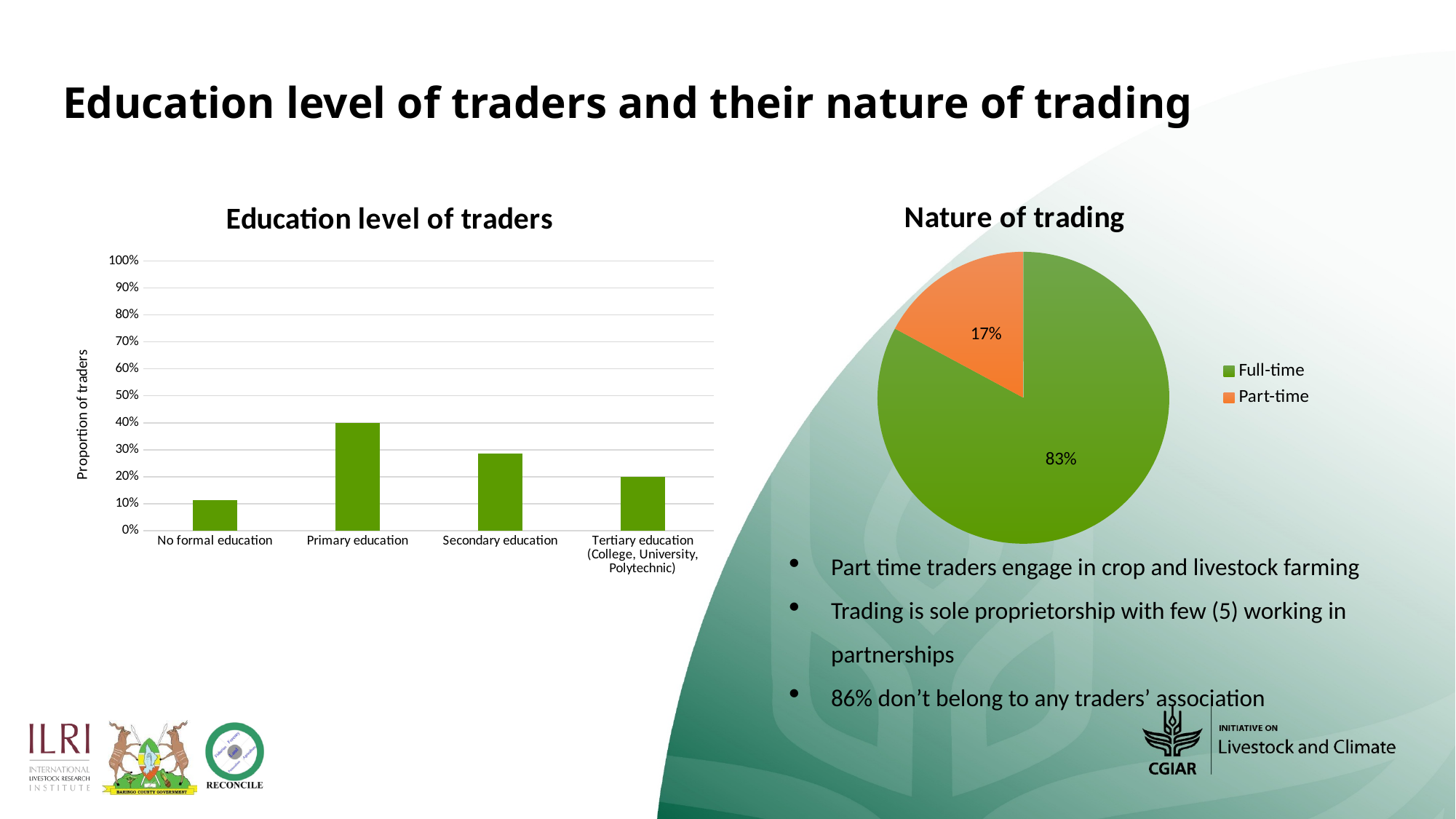
In the 'Education level of traders' chart, which education level has the highest proportion of traders? Primary education In the 'Education level of traders' chart, which education level has the lowest proportion of traders? No formal education What type of chart is 'Education level of traders'? Bar chart How many education categories are shown in the 'Education level of traders' chart? 4 In the 'Education level of traders' chart, is the value for No formal education greater or less than 20%? less In the 'Education level of traders' chart, which is larger: the value for Secondary education or the value for Tertiary education? Secondary education In the 'Education level of traders' chart, is the value for Primary education greater or less than 30%? greater In the 'Nature of trading' chart, what share of traders are Part-time? 17% What type of chart is 'Nature of trading'? Pie chart What is the y-axis label of the 'Education level of traders' chart? Proportion of traders In the 'Education level of traders' chart, is the value for Secondary education greater or less than 20%? greater In the 'Nature of trading' chart, what share of traders are Full-time? 83%